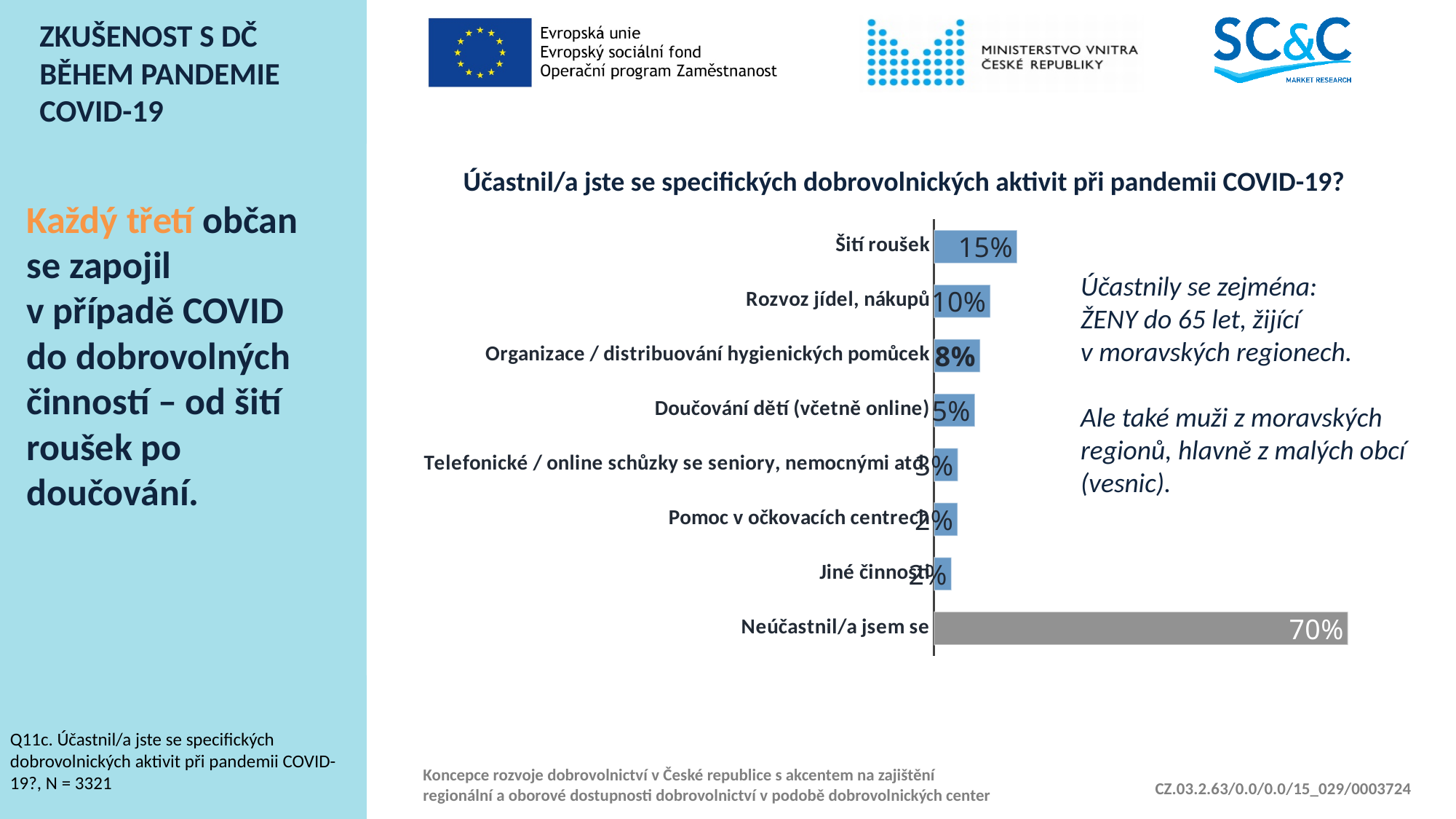
Which category has the highest value? Neúčastnil/a jsem se What is the value for "Organizace / distribuování hygienických pomůcek"? 8% How many categories does the chart show? 8 What is the value for "Rozvoz jídel, nákupů"? 10% What is the title of the chart? Účastnil/a jste se specifických dobrovolnických aktivit při pandemii COVID-19? What is the value for "Doučování dětí (včetně online)"? 5% Which is larger, "Doučování dětí (včetně online)" or "Organizace / distribuování hygienických pomůcek"? Organizace / distribuování hygienických pomůcek What is the value for "Neúčastnil/a jsem se"? 70% What is the value for "Šití roušek"? 15% What type of chart is shown on the slide? bar chart What is the difference between "Šití roušek" and "Rozvoz jídel, nákupů"? 5% Among the volunteering activities (excluding "Neúčastnil/a jsem se"), which has the highest value? Šití roušek